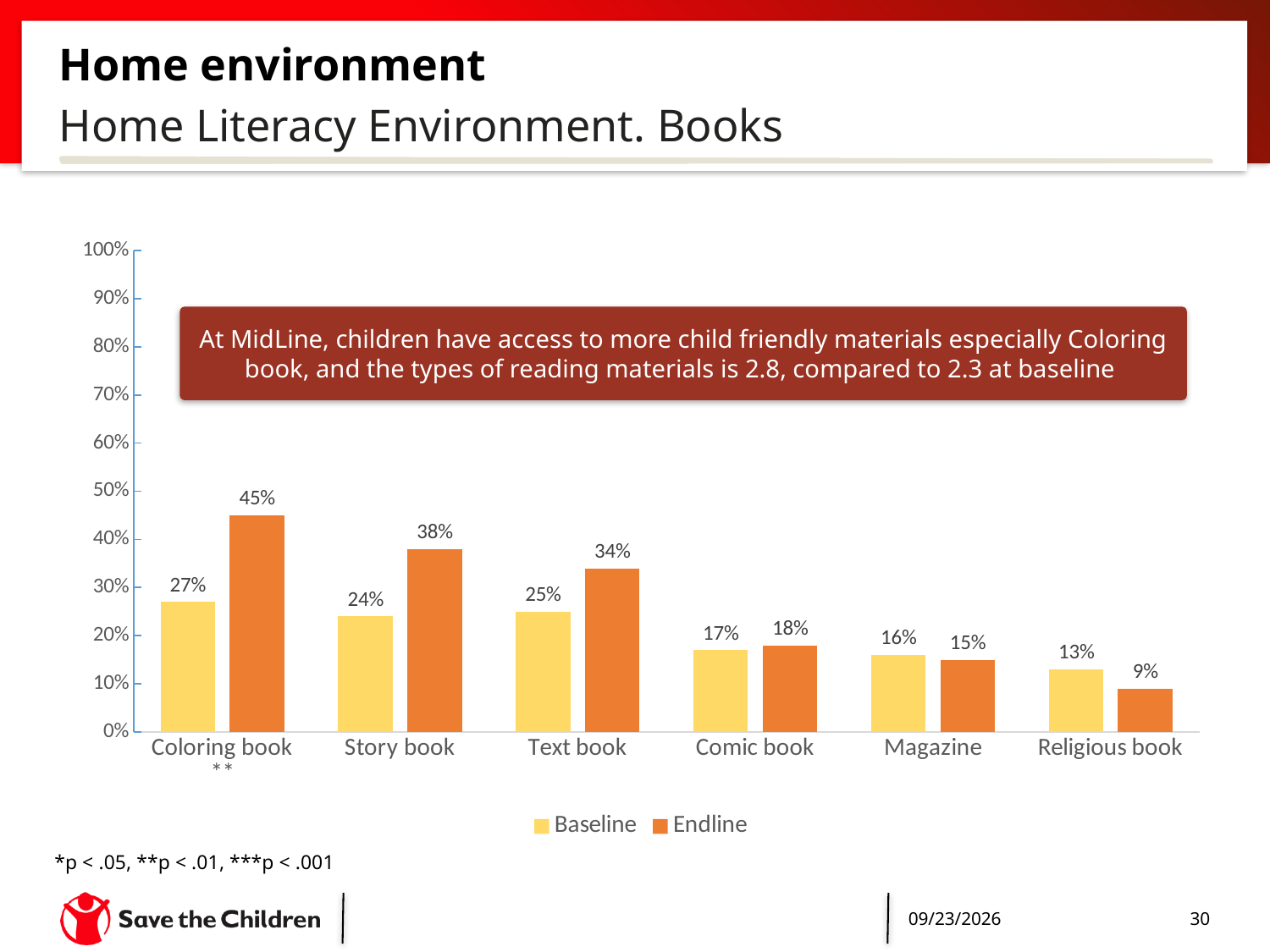
What is the Endline value for Coloring book? 45% How many series does the legend list? 2 Which category has the highest Endline value? Coloring book Which category has the lowest Baseline value? Religious book Do the Endline values rise or fall from Coloring book to Religious book along the x axis? Fall What kind of chart is shown on the slide? Bar chart What is the Baseline value for Text book? 25% How many categories are shown on the x axis? 6 What is the Endline value for Religious book? 9% Which series is shown in orange in the legend? Endline What is the difference between the Endline and Baseline values for Story book? 14% Which is larger for Magazine, the Baseline value or the Endline value? Baseline